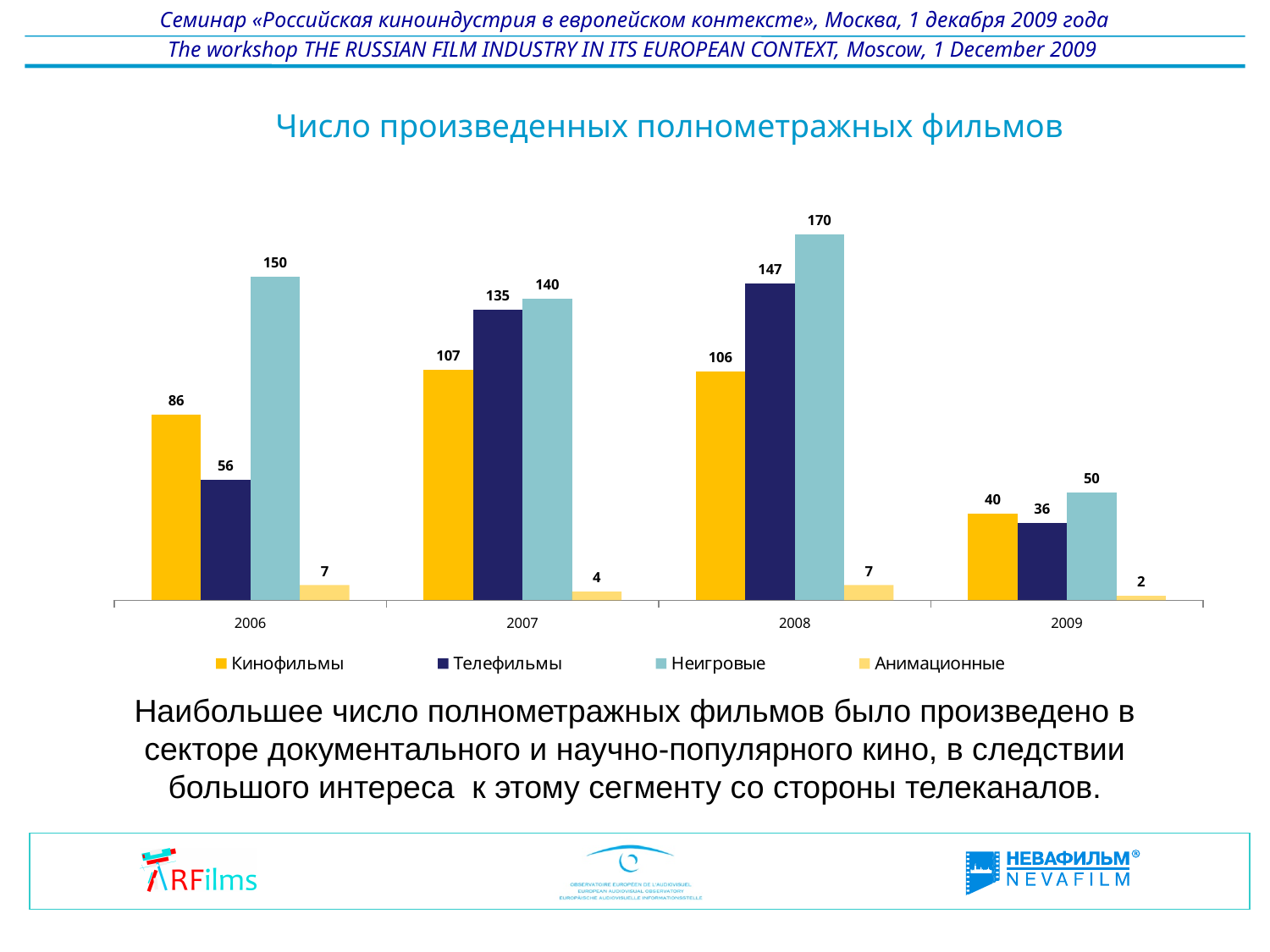
What is the value for Телефильмы in 2009? 36 What is the difference between Неигровые and Телефильмы in 2006? 94 In which year is the value for Неигровые highest? 2008 What is the value for Кинофильмы in 2006? 86 How many series does the legend list? 4 What is the value for Неигровые in 2008? 170 What is the title of the chart? Число произведенных полнометражных фильмов Which is larger in 2007: Телефильмы or Кинофильмы? Телефильмы What is the value for Анимационные in 2007? 4 What kind of chart is shown on the slide? Bar chart How many years are shown on the x axis? 4 In which year is the value for Кинофильмы lowest? 2009